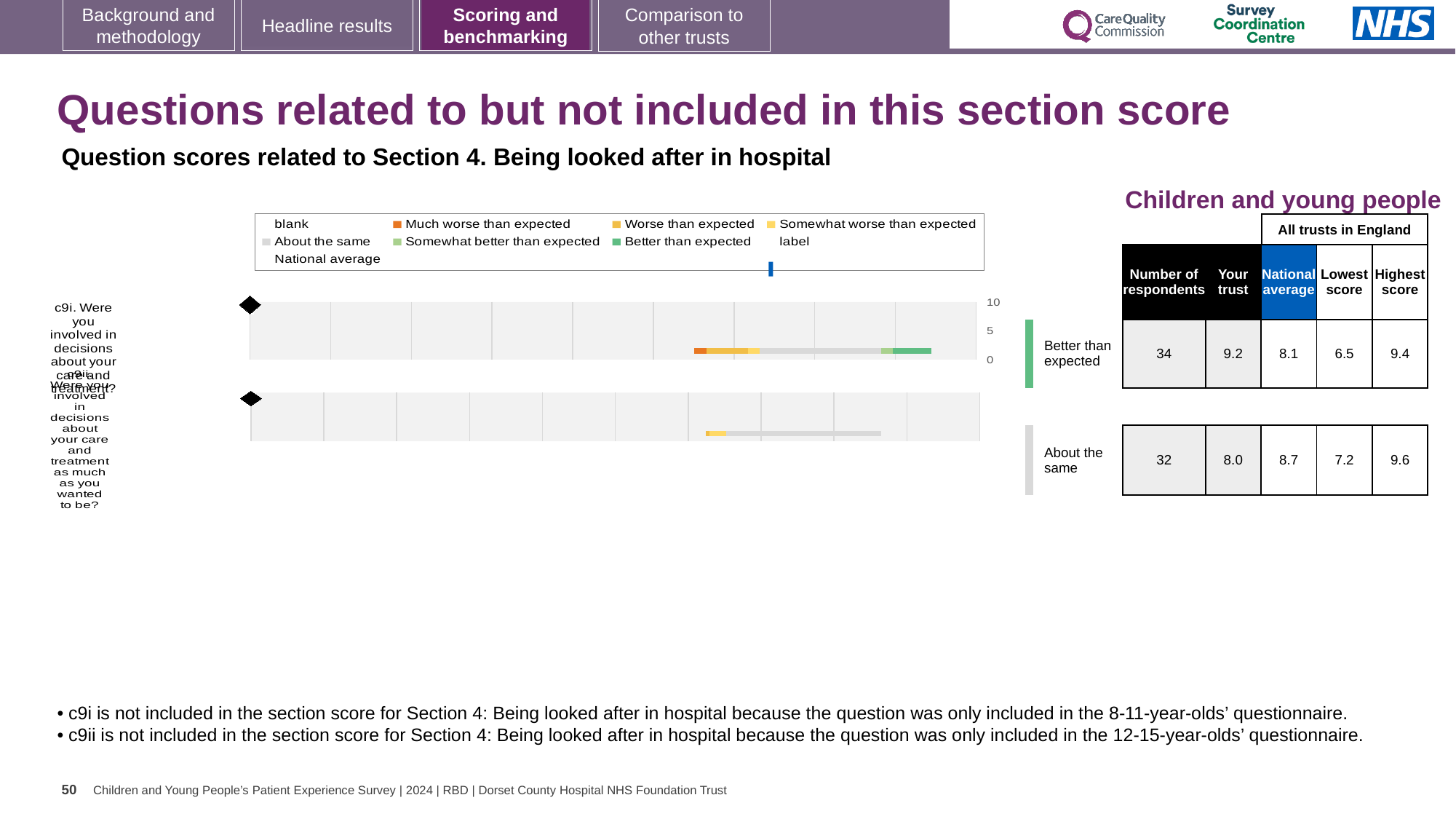
In the table beside the chart, what is the difference between the highest score and the lowest score for c9ii (the 'About the same' row)? 2.4 In the table beside the chart, what is the 'Your trust' score for c9i (the 'Better than expected' row)? 9.2 In the table beside the chart, what is the national average for c9i (the 'Better than expected' row)? 8.1 What colour represents 'Much worse than expected' in the chart legend? orange According to the table beside the chart, which question has the higher 'Your trust' score, c9i or c9ii? c9i In the table beside the chart, how many respondents are recorded for c9ii (the 'About the same' row)? 32 How many entries does the chart legend list? 9 What benchmark category is shown next to the c9ii bar? About the same What kind of chart is used to show the question scores for c9i and c9ii? bar chart How many questions (bars) are plotted in the chart? 2 What colour represents 'Better than expected' in the chart legend? green In the table beside the chart, what is the highest score across all trusts in England for c9i (the 'Better than expected' row)? 9.4